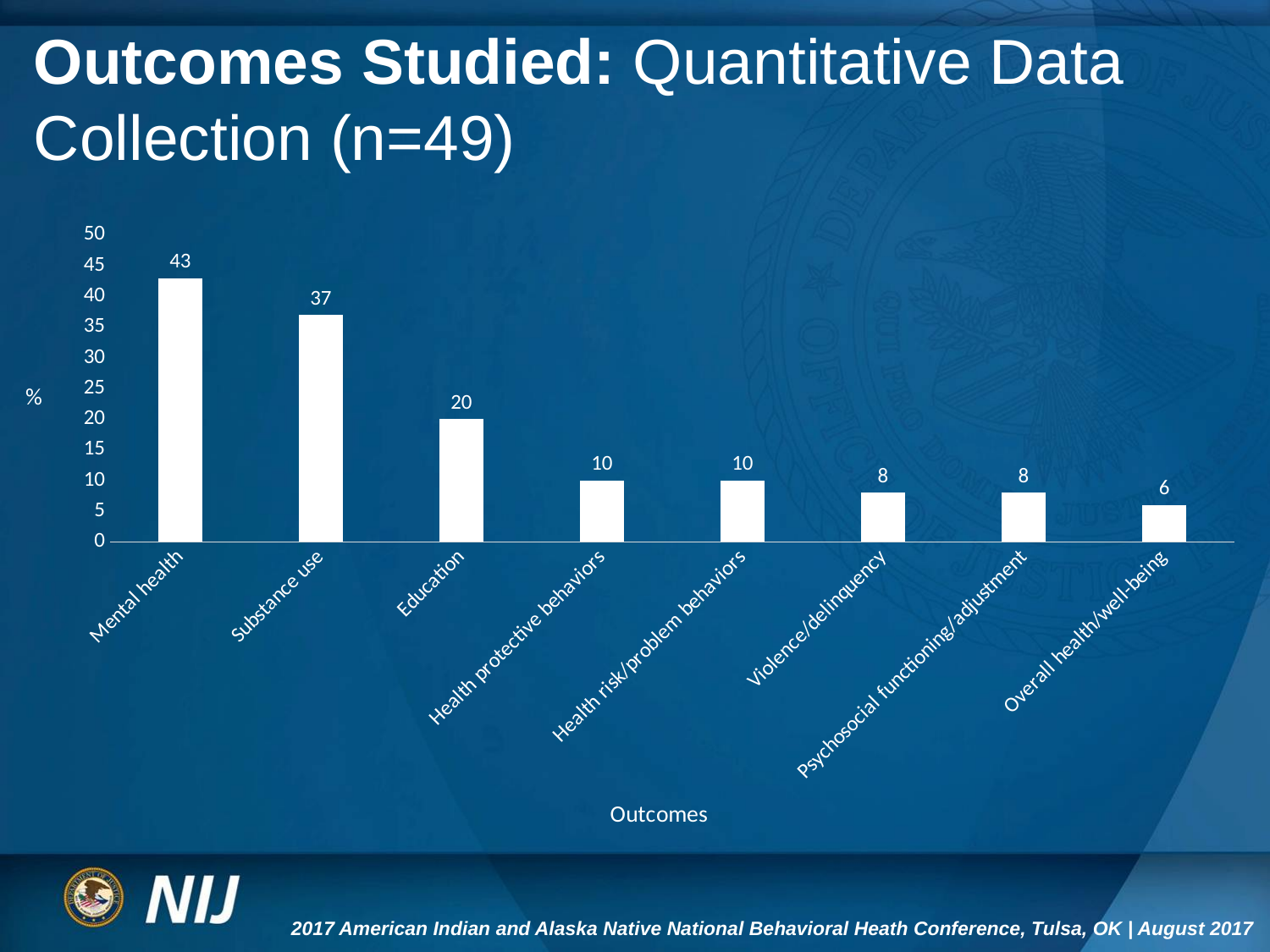
What is the value for Education? 20 What is the value for Mental health? 43 Which outcome has the highest value? Mental health What is the label of the x axis? Outcomes Which is larger, the value for Education or the value for Violence/delinquency? Education What is the value for Psychosocial functioning/adjustment? 8 What kind of chart is shown on the slide? bar chart Is the value for Substance use greater or less than 30? greater Do the values rise or fall from left to right along the x axis? fall How many outcome categories are shown on the x axis? 8 What is the difference between the values for Mental health and Substance use? 6 Which outcome has the lowest value? Overall health/well-being